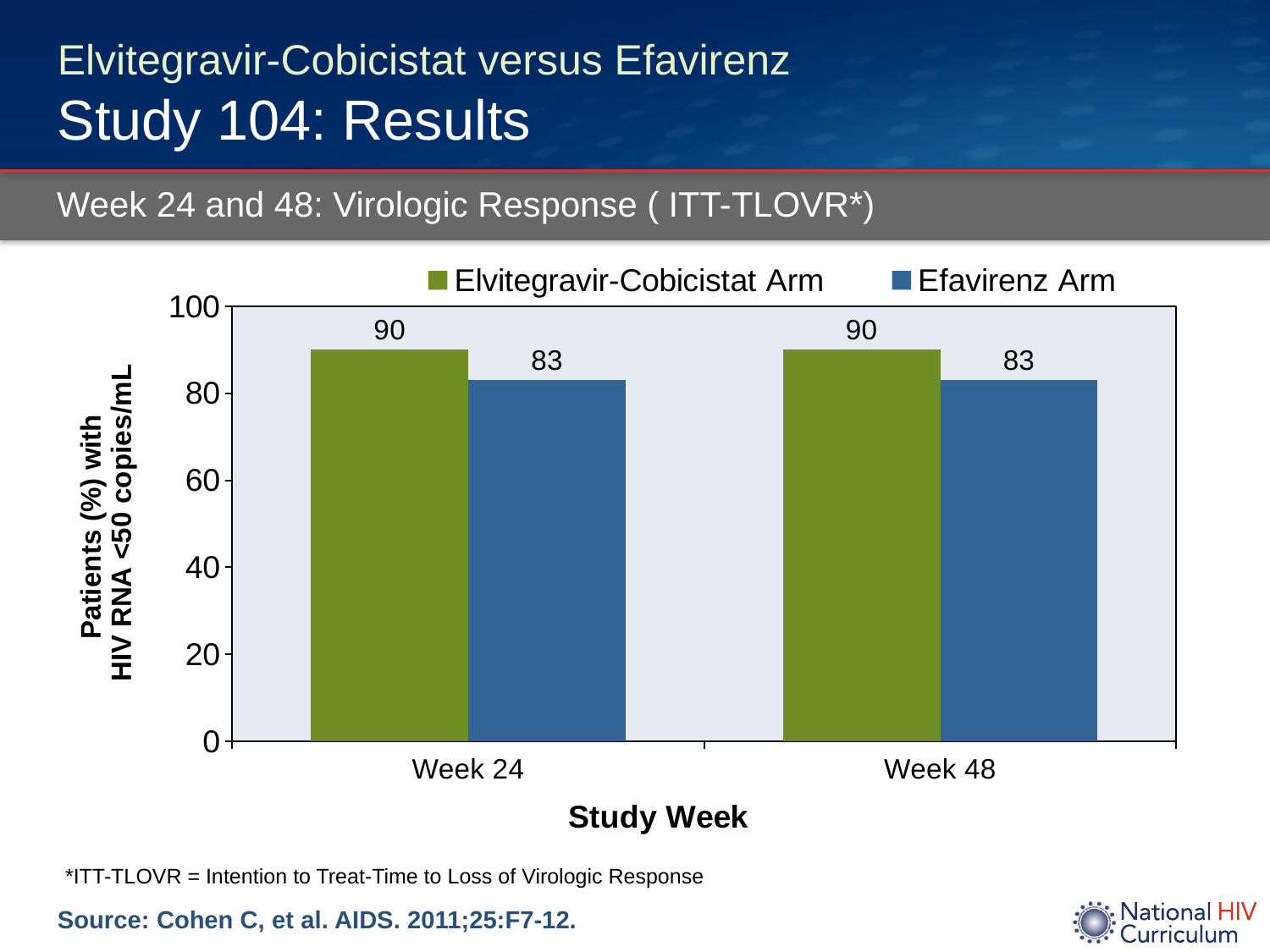
What kind of chart is shown on the slide? bar chart What is the value for the Efavirenz Arm at Week 24? 83 Does the value for the Elvitegravir-Cobicistat Arm rise, fall or stay the same from Week 24 to Week 48? stays the same What is the value for the Efavirenz Arm at Week 48? 83 How many series does the legend list? 2 What is the difference between the Elvitegravir-Cobicistat Arm and the Efavirenz Arm at Week 48? 7 Is the value for the Efavirenz Arm at Week 24 greater or less than 80? greater Which arm has the higher value at Week 24? Elvitegravir-Cobicistat Arm What is the label of the x axis? Study Week What is the value for the Elvitegravir-Cobicistat Arm at Week 24? 90 Which colour represents the Efavirenz Arm in the legend? blue How many study weeks are shown on the x axis? 2